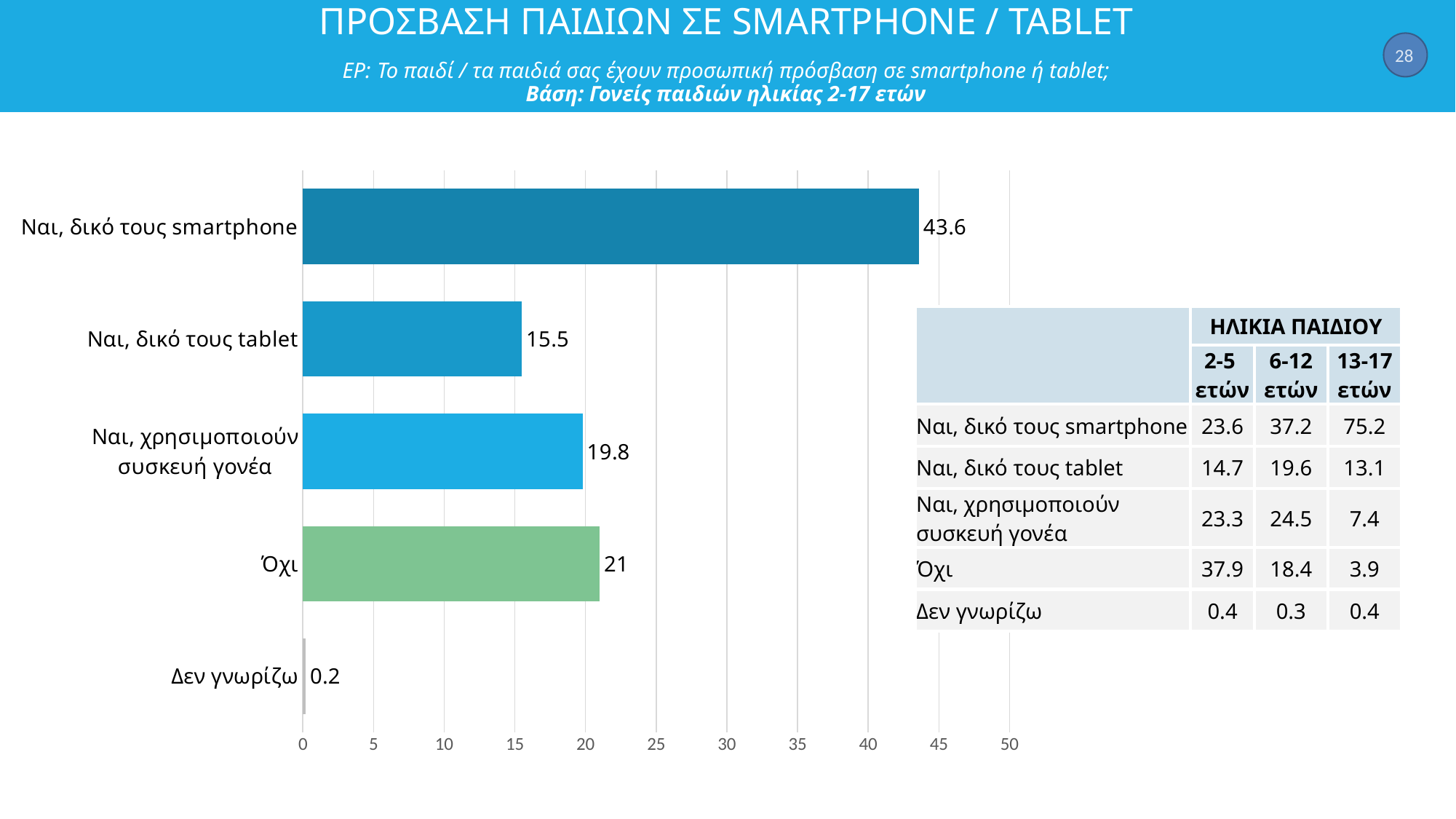
What is the value for "Όχι"? 21 Is the value for "Ναι, δικό τους smartphone" greater or less than 40? greater Which category has the highest value? Ναι, δικό τους smartphone What is the value for "Ναι, δικό τους smartphone"? 43.6 What is the difference between the values for "Ναι, δικό τους smartphone" and "Όχι"? 22.6 What is the value for "Ναι, δικό τους tablet"? 15.5 How many categories are shown in the bar chart? 5 Which is larger, the value for "Ναι, δικό τους tablet" or "Ναι, χρησιμοποιούν συσκευή γονέα"? Ναι, χρησιμοποιούν συσκευή γονέα What is the value for "Δεν γνωρίζω"? 0.2 Which category has the lowest value? Δεν γνωρίζω What is the value for "Ναι, χρησιμοποιούν συσκευή γονέα"? 19.8 What kind of chart is shown on the slide? bar chart